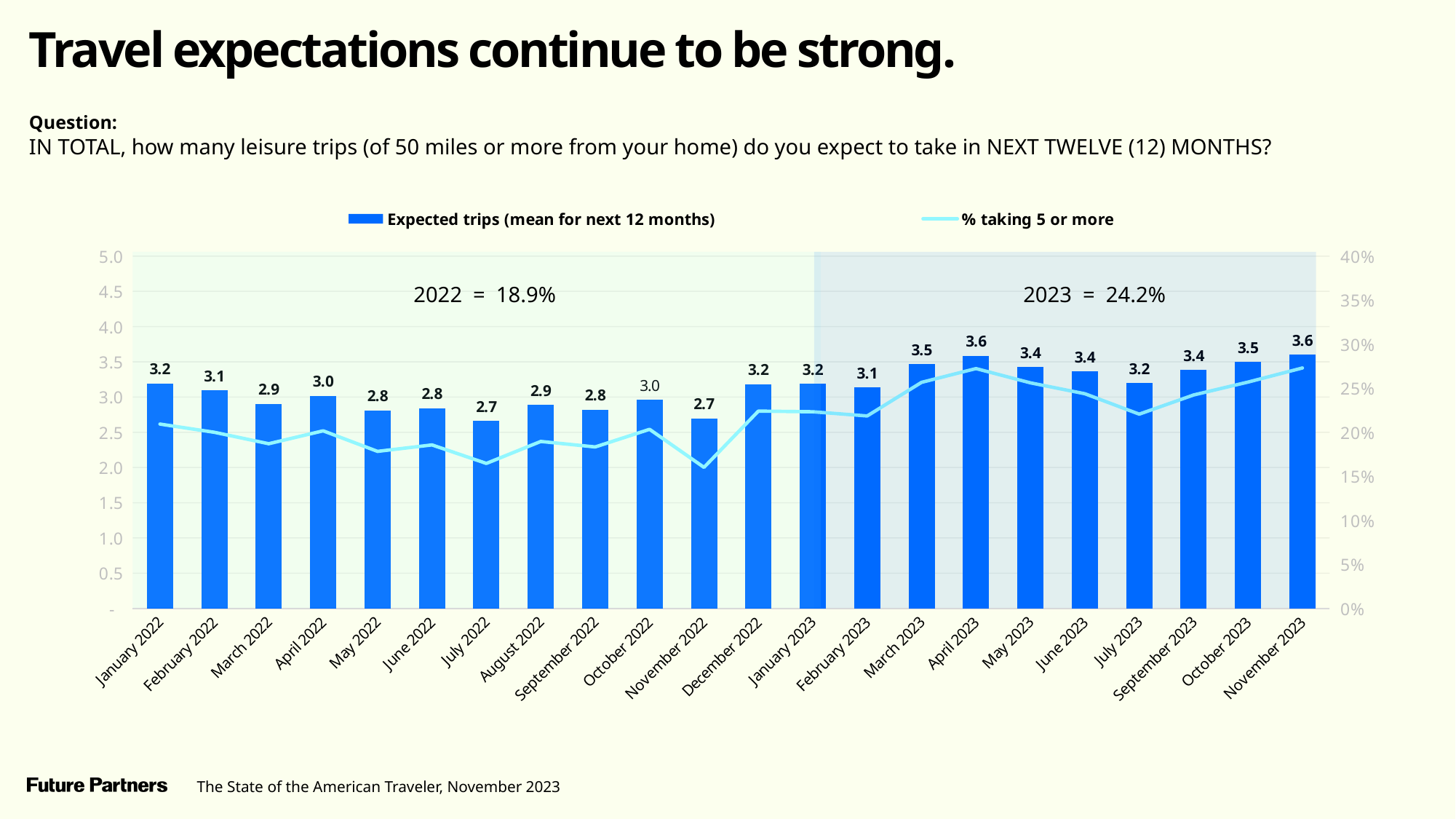
Is the % taking 5 or more value for April 2023 greater or less than 25%? greater What is the difference between the expected trips values for November 2023 and November 2022? 0.9 Which has a higher expected trips value, March 2022 or March 2023? March 2023 How many months are shown on the x axis of the chart? 22 What is the expected trips value for November 2022? 2.7 Is the % taking 5 or more value for November 2022 greater or less than 20%? less What is the highest expected trips value shown on the chart? 3.6 How many series does the legend list? 2 What is the expected trips value for July 2023? 3.2 What is the expected trips value for April 2023? 3.6 What is the annual % taking 5 or more figure shown for 2023? 24.2% What is the lowest expected trips value shown on the chart? 2.7